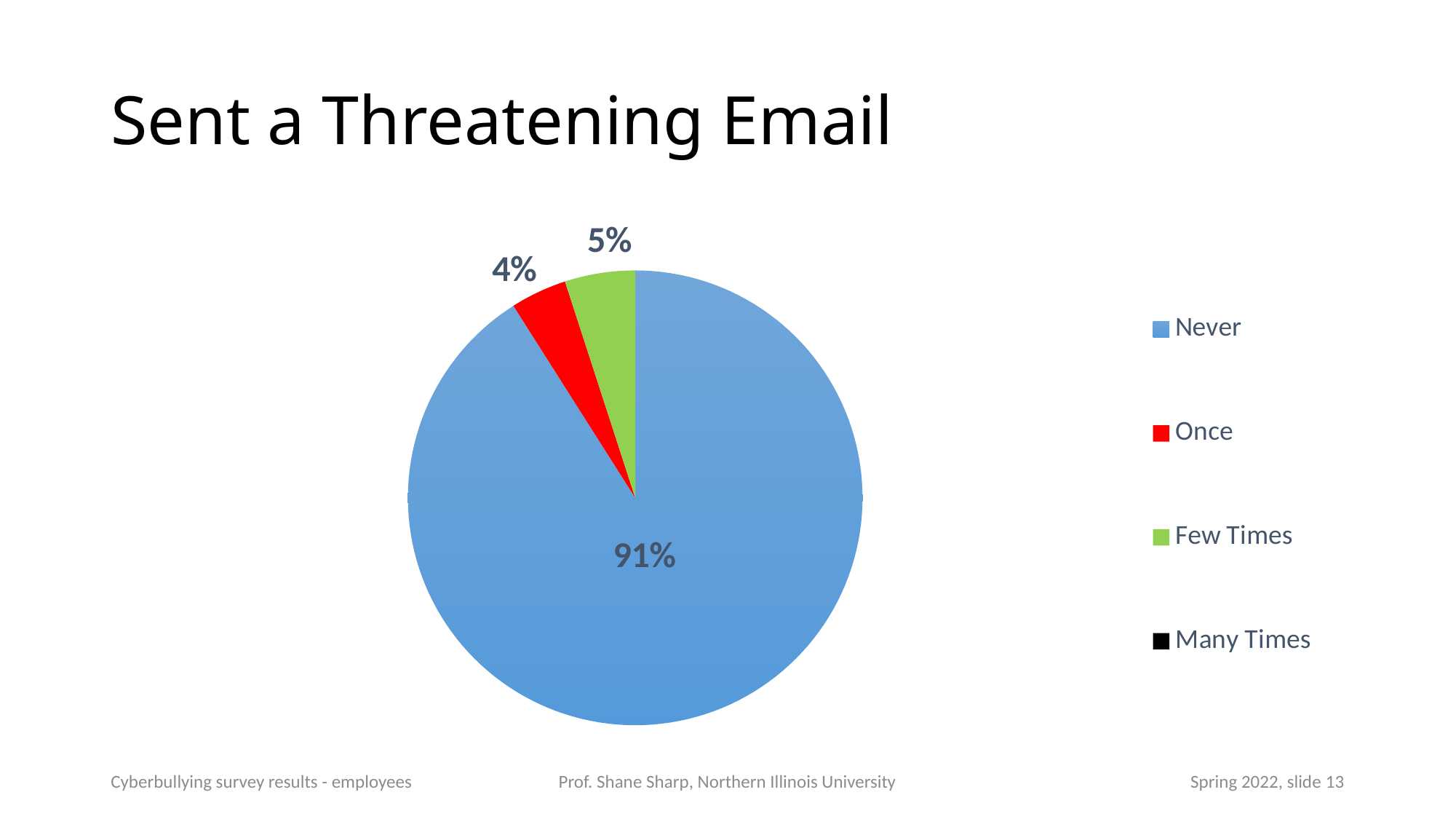
What is the difference in percentage points between the Few Times slice and the Once slice? 1 Which of the labelled slices is larger, Once or Few Times? Few Times What is the combined share of the Once and Few Times slices? 9% What percentage of the pie is the Few Times slice? 5% What percentage of the pie is the Never slice? 91% What kind of chart is shown on the slide? pie chart What is the difference in percentage points between the Never slice and the Few Times slice? 86 How many entries does the legend list? 4 What colour is the Once slice in the pie chart? red What percentage of the pie is the Once slice? 4% What is the title of the chart on the slide? Sent a Threatening Email Which category has the largest share of the pie? Never